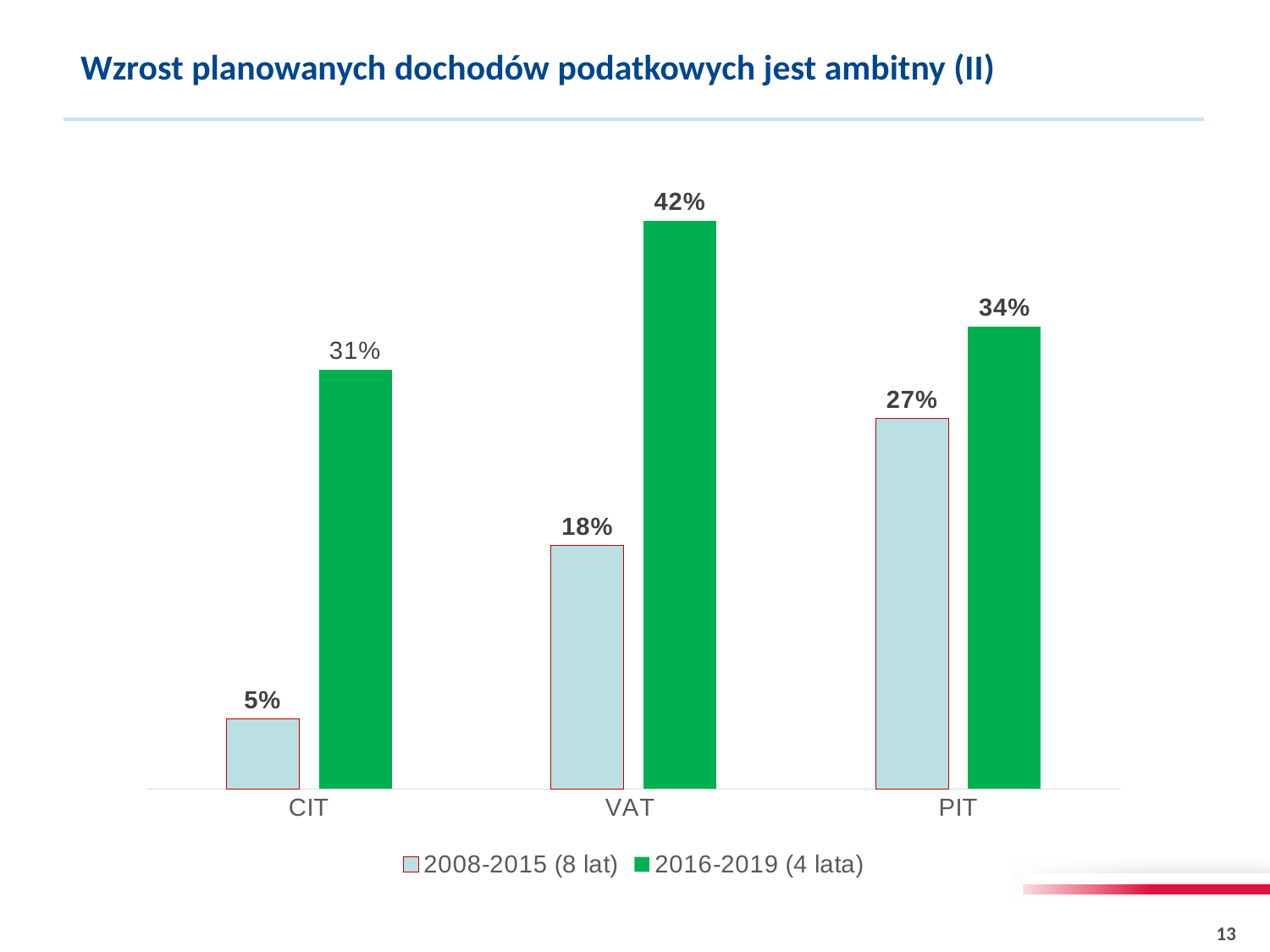
What is the difference between the 2016-2019 (4 lata) and 2008-2015 (8 lat) values for VAT? 24% What is the value for CIT in the 2008-2015 (8 lat) series? 5% What is the value for VAT in the 2016-2019 (4 lata) series? 42% How many categories are shown on the x axis? 3 What is the value for PIT in the 2008-2015 (8 lat) series? 27% Which is larger: the 2008-2015 (8 lat) value for PIT or the 2008-2015 (8 lat) value for VAT? PIT What is the title of the slide? Wzrost planowanych dochodów podatkowych jest ambitny (II) What kind of chart is shown on the slide? Bar chart Which category has the lowest value in the 2008-2015 (8 lat) series? CIT How many series does the legend list? 2 What is the difference between the 2016-2019 (4 lata) and 2008-2015 (8 lat) values for CIT? 26% Which category has the highest value in the 2016-2019 (4 lata) series? VAT